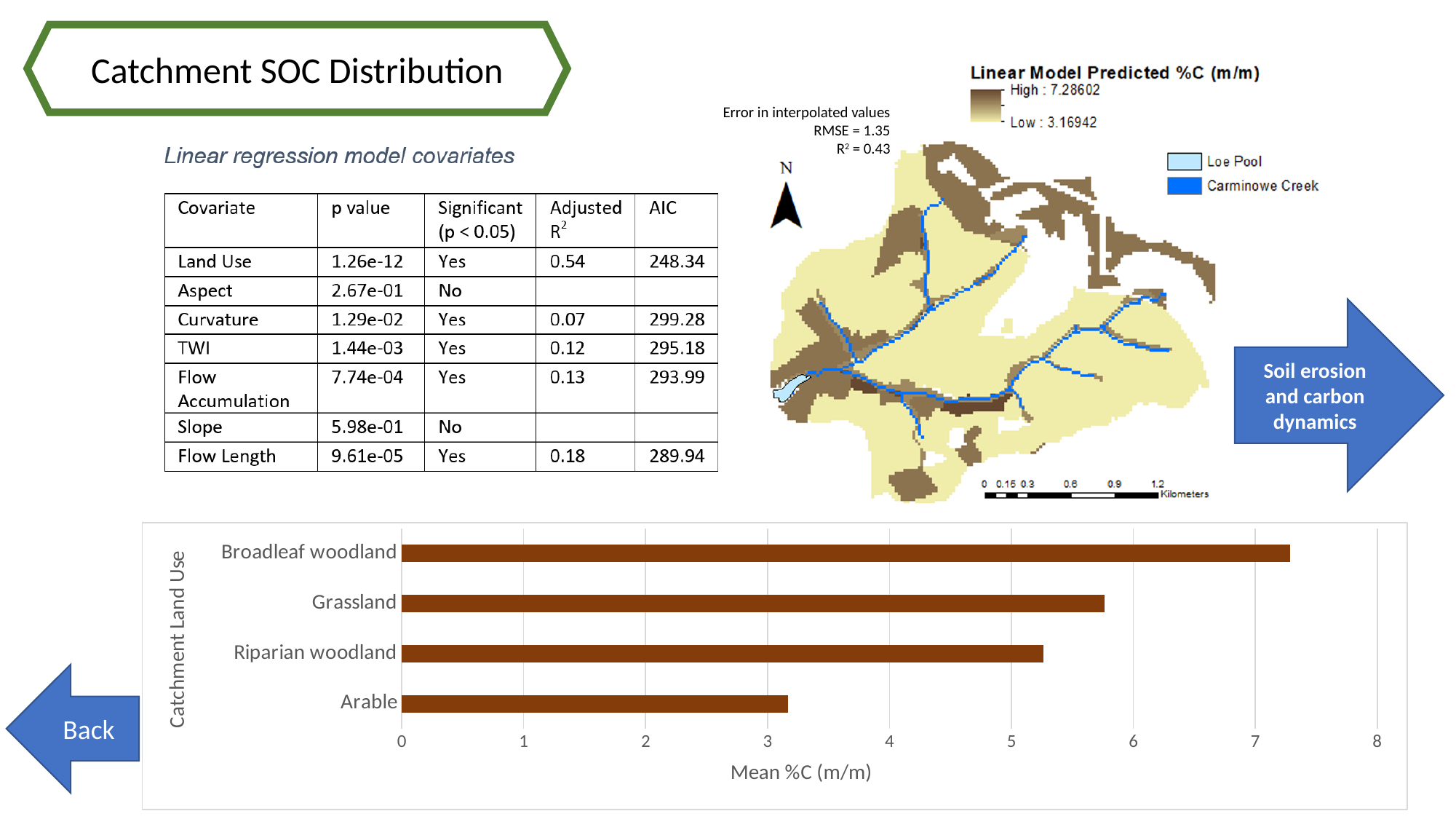
Is the mean %C value for Broadleaf woodland greater or less than 7? greater Is the mean %C value for Riparian woodland greater or less than 6? less Which land use category has the lowest mean %C in the bar chart? Arable In the bar chart, which has a higher mean %C, Grassland or Riparian woodland? Grassland Is the mean %C value for Arable greater or less than 4? less Which land use category has the highest mean %C in the bar chart? Broadleaf woodland How many land use categories are plotted in the bar chart? 4 In the bar chart, which has a higher mean %C, Arable or Riparian woodland? Riparian woodland What is the title of the horizontal axis of the bar chart? Mean %C (m/m) What kind of chart is shown at the bottom of the slide? bar chart What is the title of the vertical axis of the bar chart? Catchment Land Use